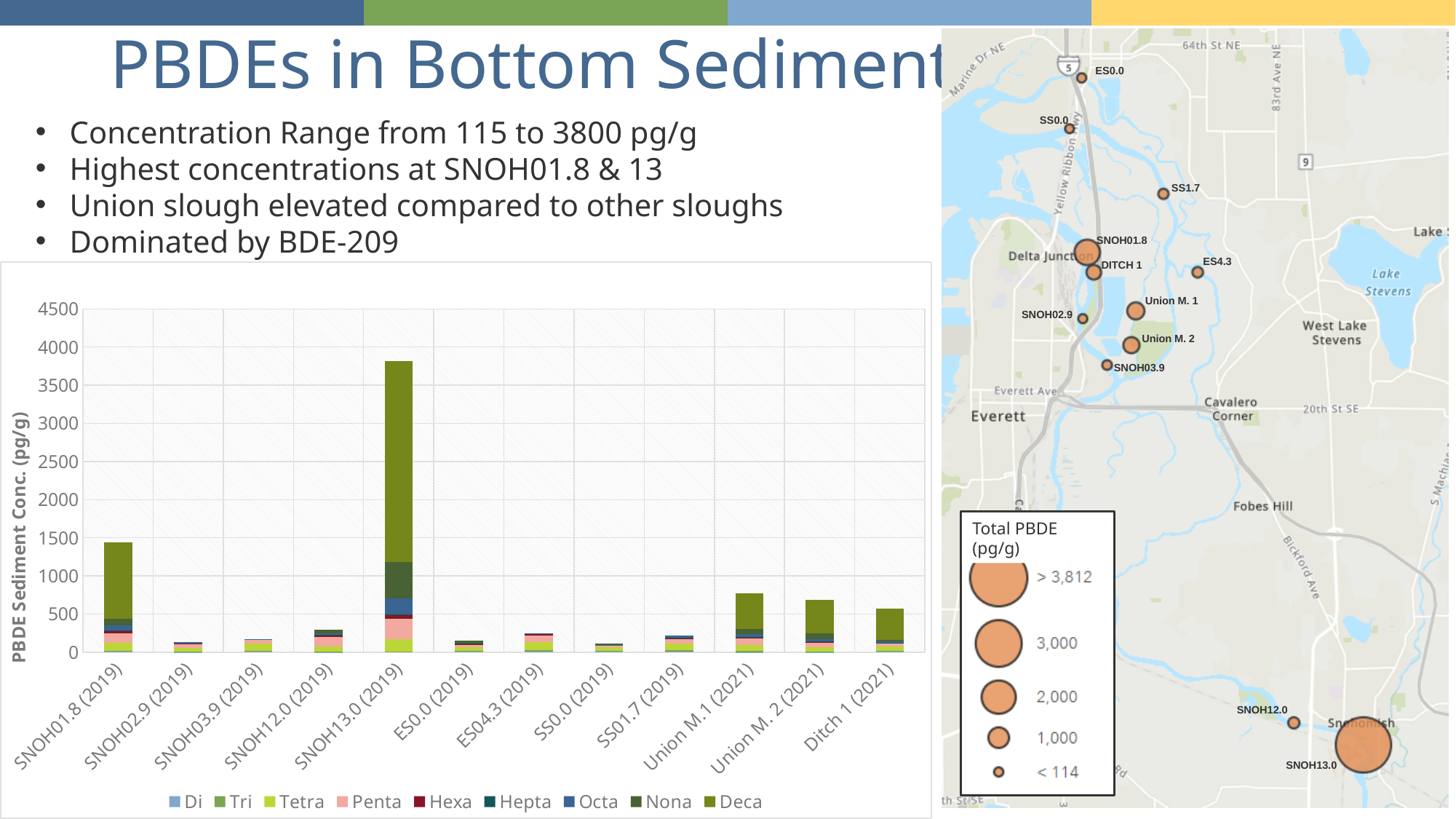
Is the total bar for SNOH12.0 (2019) greater or less than 500? less What is the label of the y axis of the bar chart? PBDE Sediment Conc. (pg/g) Which has the larger total PBDE concentration, SNOH01.8 (2019) or Union M.1 (2021)? SNOH01.8 (2019) Which has the larger total PBDE concentration, Union M.1 (2021) or Ditch 1 (2021)? Union M.1 (2021) How many sampling sites (categories) are plotted along the x axis of the bar chart? 12 Which site has the highest total PBDE sediment concentration in the bar chart? SNOH13.0 (2019) What kind of chart is shown on the slide? Stacked bar chart How many series does the chart legend list? 9 Which series is listed last in the chart legend? Deca Is the total bar for SNOH01.8 (2019) greater or less than 1000? greater Is the total bar for Union M.1 (2021) greater or less than 500? greater